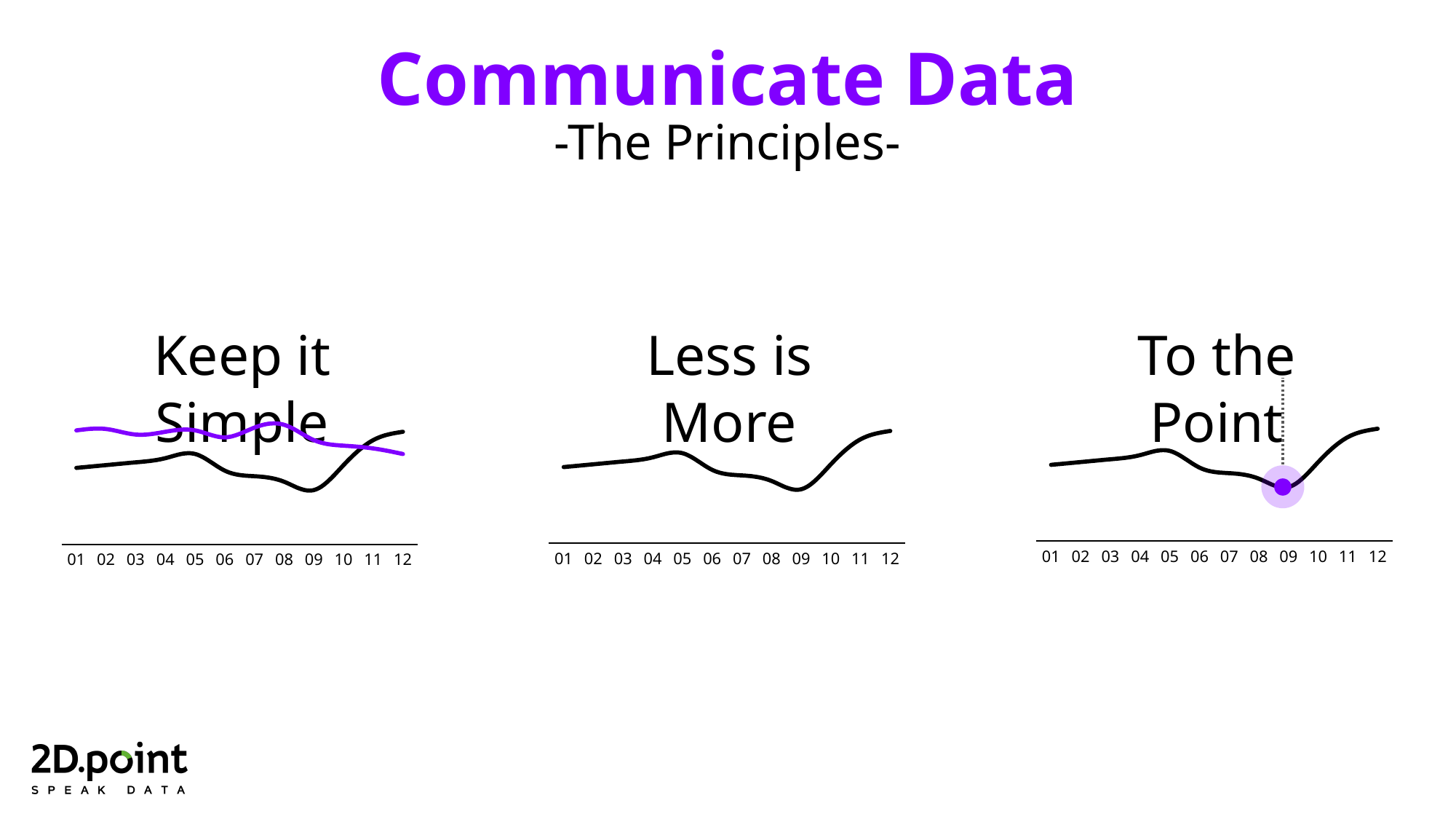
In the "To the Point" chart, which x-axis label is marked with a highlighted purple dot? 09 In the "Less is More" chart, which is higher, the value at 12 or the value at 09? 12 In the "Less is More" chart, does the line rise or fall from 09 to 12? rise In the "To the Point" chart, at which x-axis label does the line reach its lowest point? 09 How many lines are plotted in the "Keep it Simple" chart? 2 In the "Keep it Simple" chart, which is higher at 09, the purple line or the black line? the purple line How many lines are plotted in the "Less is More" chart? 1 In the "Less is More" chart, at which x-axis label is the line lowest? 09 In the "To the Point" chart, does the line rise or fall from 05 to 09? fall How many points are labelled on the x axis of the "To the Point" chart? 12 What is the first x-axis label on the "Keep it Simple" chart? 01 What kind of chart is shown under the heading "Less is More"? line chart